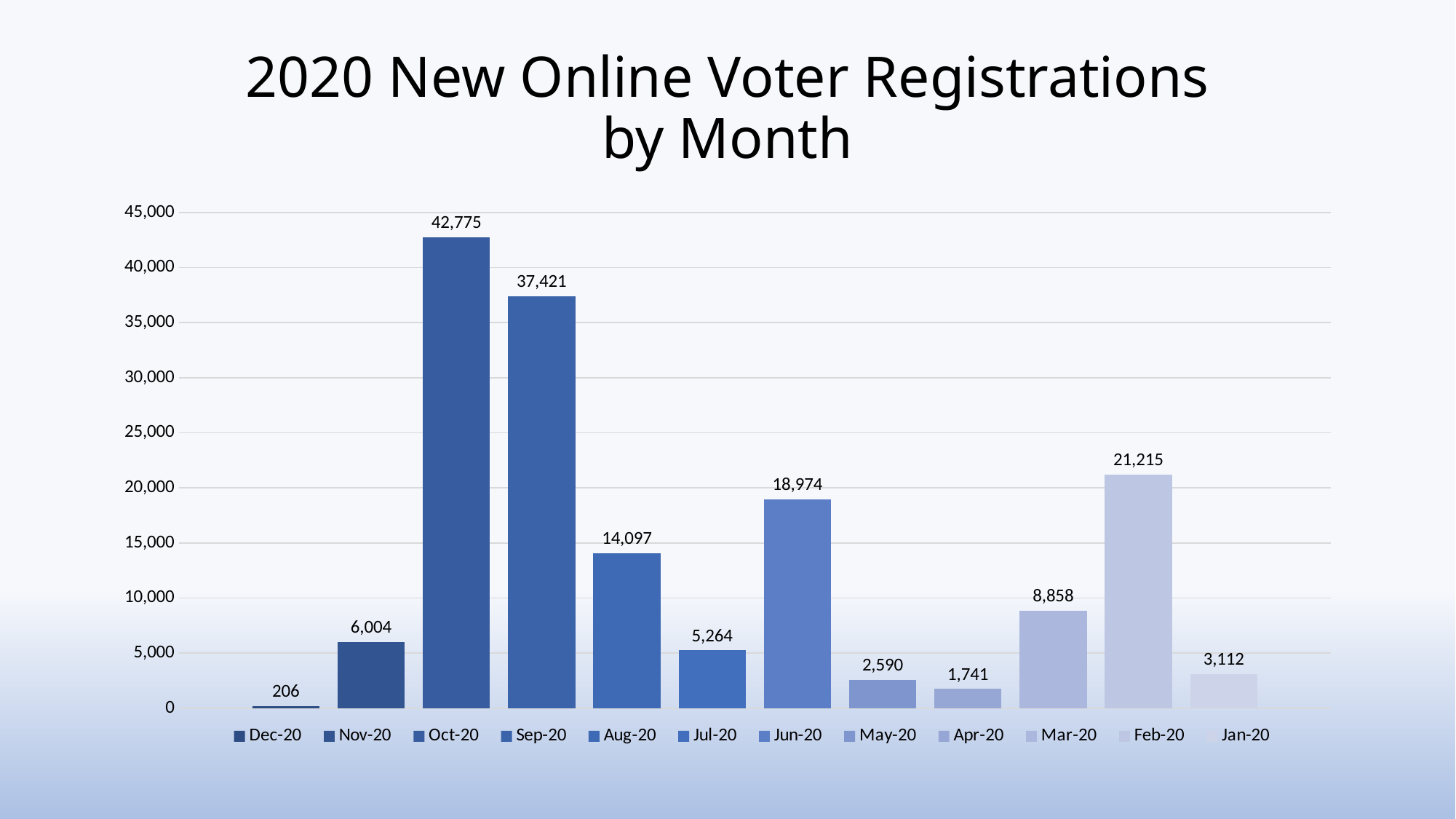
What kind of chart is shown on the slide? bar chart What is the difference between the values for Oct-20 and Sep-20? 5,354 How many entries does the legend list? 12 Is the value for Mar-20 greater or less than 10,000? less Which is larger, the value for Jun-20 or the value for Aug-20? Jun-20 How many bars are plotted on the chart? 12 What is the title of the chart? 2020 New Online Voter Registrations by Month Which month has the highest number of new online voter registrations? Oct-20 Which month has the lowest number of new online voter registrations? Dec-20 What is the value for Oct-20? 42,775 What is the value for Feb-20? 21,215 What is the value for Dec-20? 206